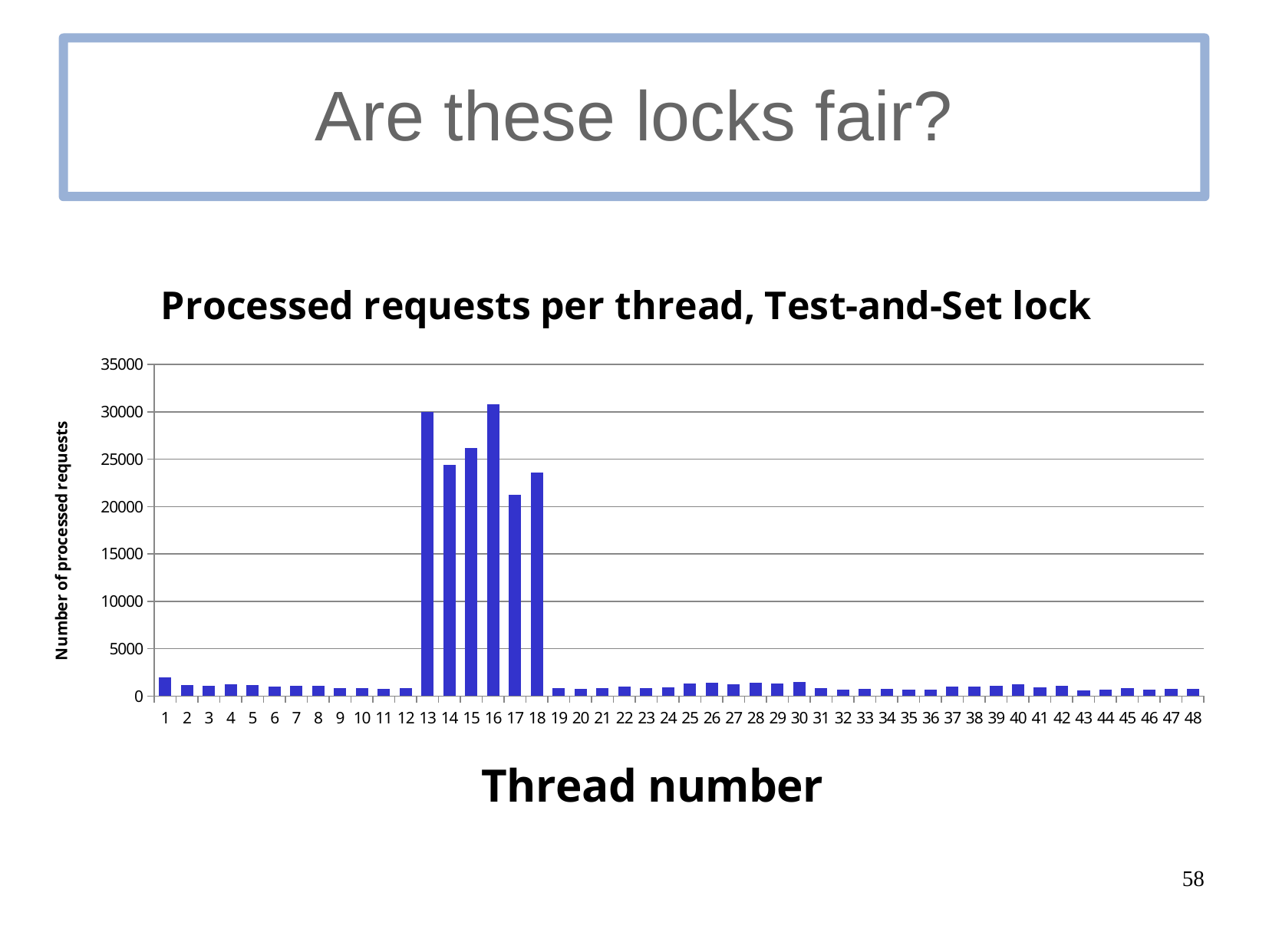
What is the title of the chart? Processed requests per thread, Test-and-Set lock Is the value for thread 17 greater or less than 25000? less Is the value for thread 1 greater or less than 5000? less What is the label of the x axis of the chart? Thread number Which has a higher value, thread 13 or thread 14? thread 13 What kind of chart is shown on the slide? bar chart Which has a higher value, thread 1 or thread 15? thread 15 Is the value for thread 13 greater or less than 25000? greater Which has a higher value, thread 16 or thread 17? thread 16 How many threads (categories) are plotted on the x axis? 48